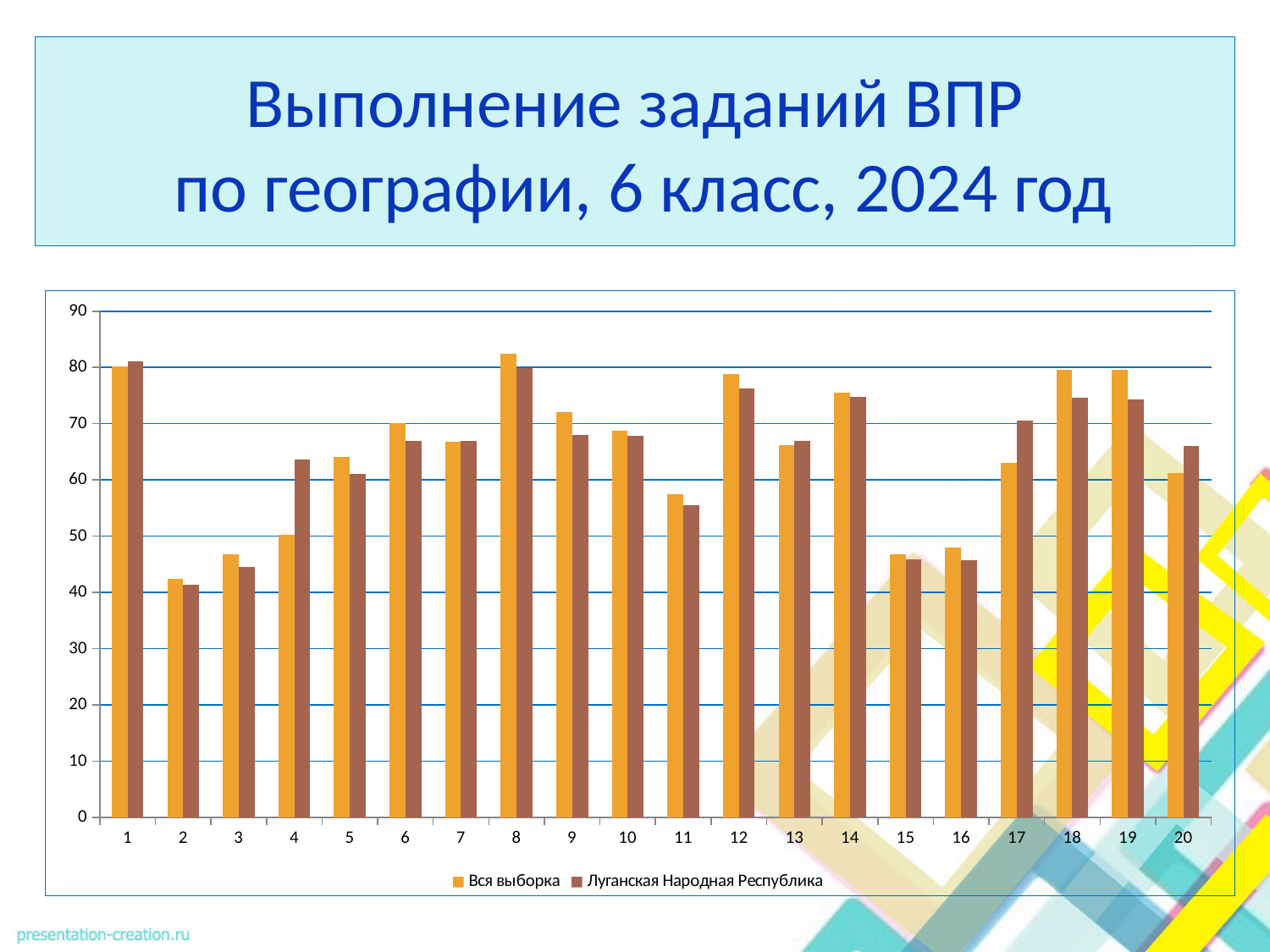
Is the value for Луганская Народная Республика at task 4 greater or less than 60? greater Is the value for Вся выборка at task 15 greater or less than 50? less For which task number is the value for Вся выборка the lowest? 2 For which task number is the value for Вся выборка the highest? 8 What are the two series named in the legend? Вся выборка; Луганская Народная Республика For which task number is the value for Луганская Народная Республика the lowest? 2 How many categories (task numbers) are shown on the x axis? 20 Is the value for Вся выборка at task 12 greater or less than 70? greater For task 18, which series has the larger value: Вся выборка or Луганская Народная Республика? Вся выборка How many series does the legend list? 2 For task 4, which series has the larger value: Вся выборка or Луганская Народная Республика? Луганская Народная Республика What kind of chart is shown on the slide? bar chart